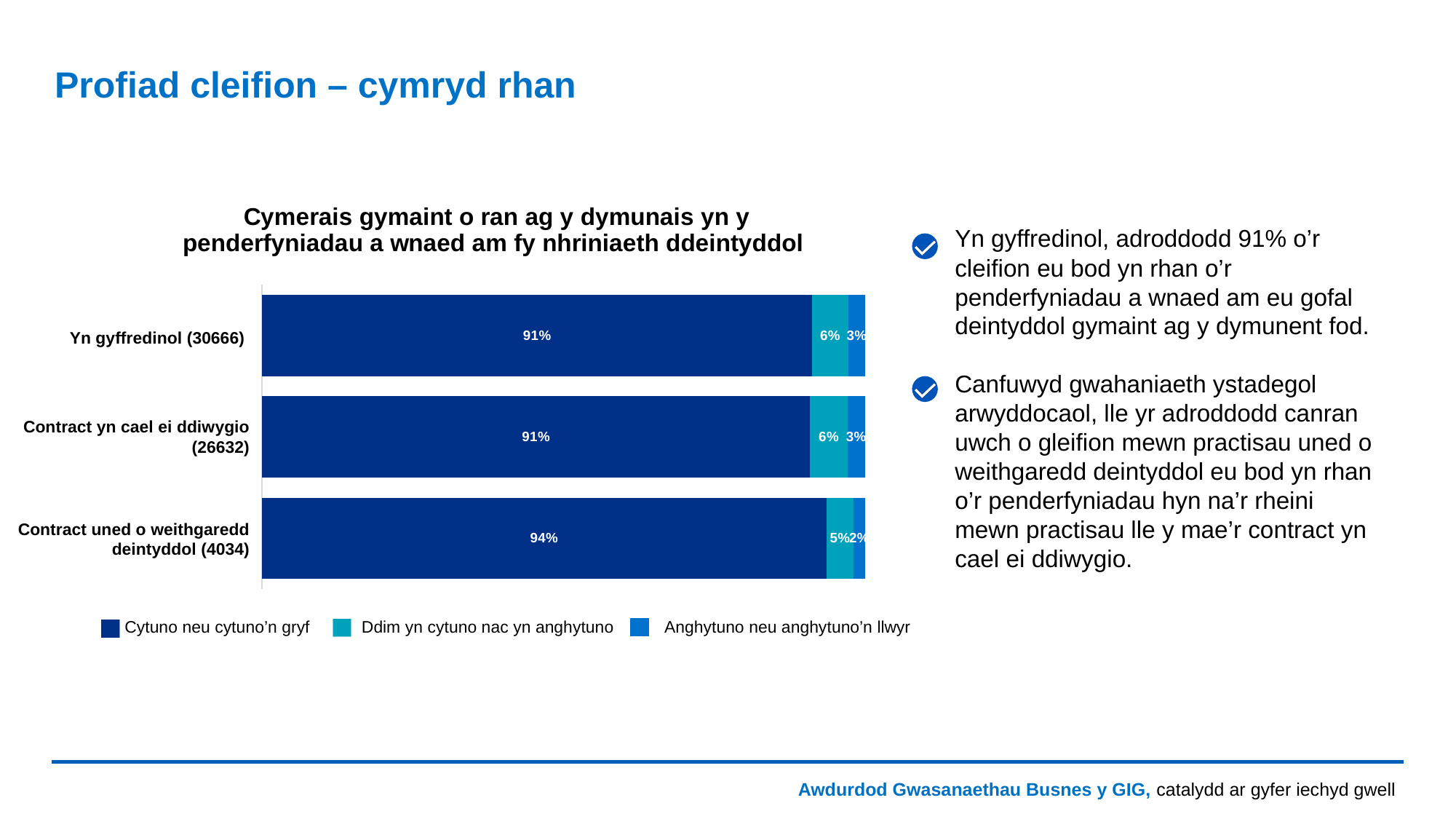
What is the difference between the 'Cytuno neu cytuno'n gryf' values for 'Contract uned o weithgaredd deintyddol (4034)' and 'Contract yn cael ei ddiwygio (26632)'? 3% What is the 'Ddim yn cytuno nac yn anghytuno' value for 'Contract yn cael ei ddiwygio (26632)'? 6% What is the title of the chart? Cymerais gymaint o ran ag y dymunais yn y penderfyniadau a wnaed am fy nhriniaeth ddeintyddol How many categories are plotted in the chart? 3 What is the 'Cytuno neu cytuno'n gryf' value for 'Contract uned o weithgaredd deintyddol (4034)'? 94% Which category has the highest 'Cytuno neu cytuno'n gryf' value? Contract uned o weithgaredd deintyddol (4034) How many series does the legend list? 3 Which category has the lowest 'Ddim yn cytuno nac yn anghytuno' value? Contract uned o weithgaredd deintyddol (4034) Which is larger: the 'Anghytuno neu anghytuno'n llwyr' value for 'Yn gyffredinol (30666)' or for 'Contract uned o weithgaredd deintyddol (4034)'? Yn gyffredinol (30666) What is the 'Anghytuno neu anghytuno'n llwyr' value for 'Contract uned o weithgaredd deintyddol (4034)'? 2% What kind of chart is shown on the slide? Stacked bar chart What is the 'Cytuno neu cytuno'n gryf' value for 'Yn gyffredinol (30666)'? 91%